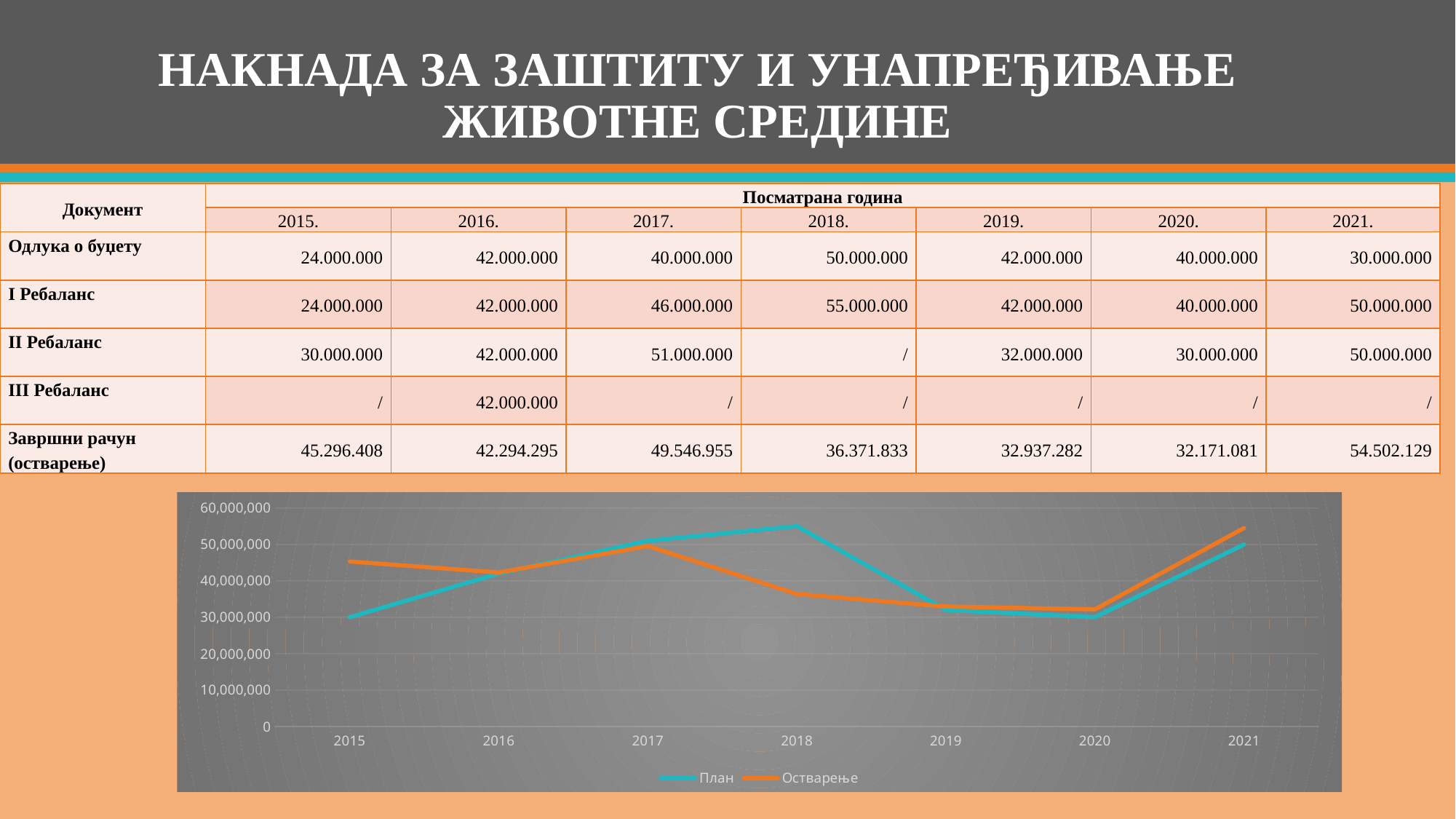
In which year does the Остварење series reach its highest value? 2021 How many years are plotted along the x axis of the chart? 7 Is the value for Остварење in 2018 greater or less than 40,000,000? less Is the value for План in 2018 greater or less than 50,000,000? greater Is the value for Остварење in 2015 greater or less than 40,000,000? greater Does the План series rise or fall from 2018 to 2020? fall In 2018, which series has the larger value, План or Остварење? План How many series does the chart's legend list? 2 In 2015, which series has the larger value, План or Остварење? Остварење In which year does the План series reach its highest value? 2018 What kind of chart is shown on the slide? line chart